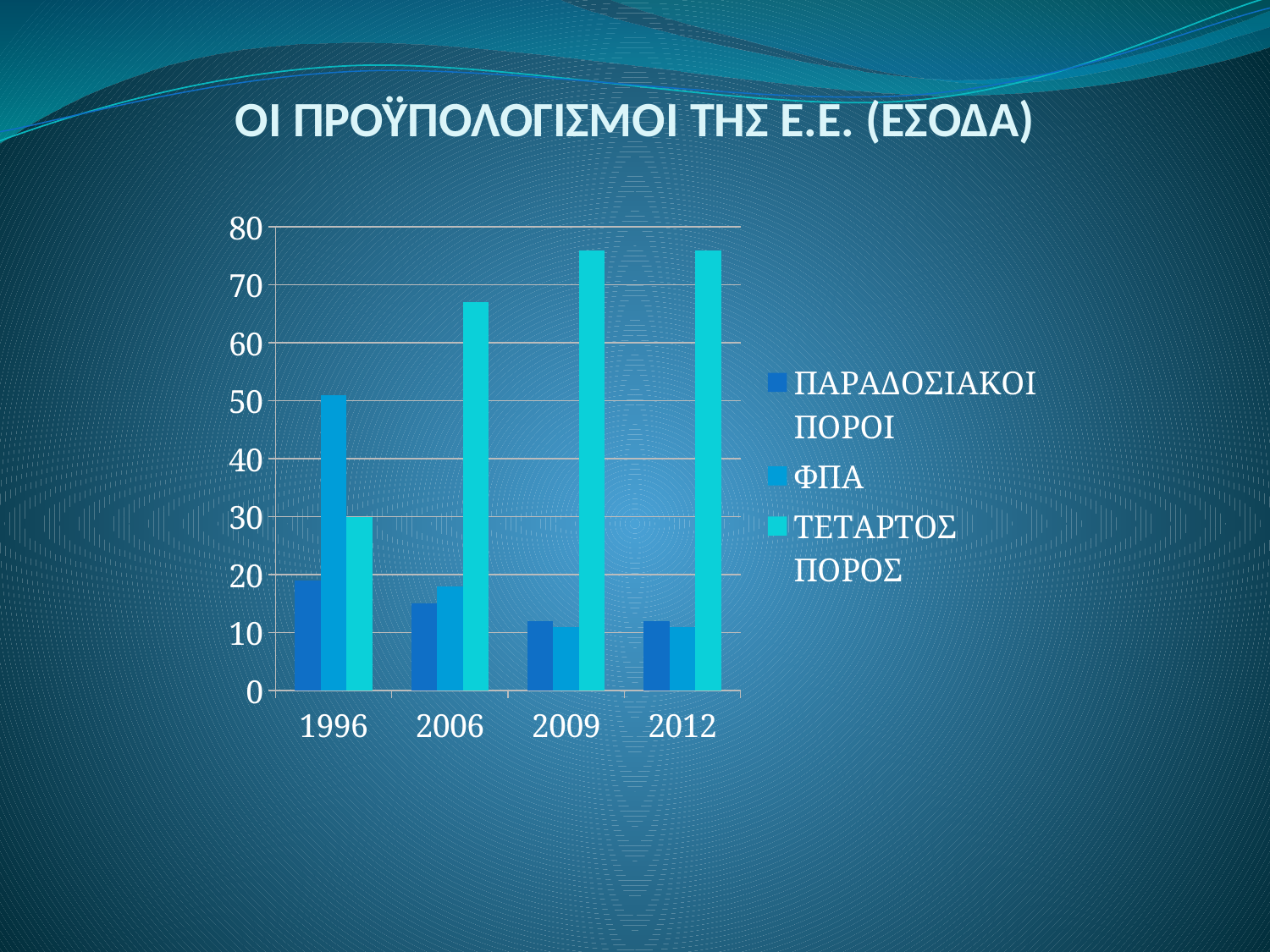
In which year is the value for ΦΠΑ highest? 1996 What is the title of the chart on the slide? ΟΙ ΠΡΟΫΠΟΛΟΓΙΣΜΟΙ ΤΗΣ Ε.Ε. (ΕΣΟΔΑ) Which series is shown in the lightest (cyan) colour in the legend? ΤΕΤΑΡΤΟΣ ΠΟΡΟΣ In which year is the value for ΤΕΤΑΡΤΟΣ ΠΟΡΟΣ lowest? 1996 In 1996, which is larger: ΦΠΑ or ΤΕΤΑΡΤΟΣ ΠΟΡΟΣ? ΦΠΑ Does the value for ΤΕΤΑΡΤΟΣ ΠΟΡΟΣ rise or fall from 1996 to 2012? rise How many years are shown on the x axis of the chart? 4 In which year is the value for ΠΑΡΑΔΟΣΙΑΚΟΙ ΠΟΡΟΙ highest? 1996 What kind of chart is shown on the slide? bar chart How many series does the chart's legend list? 3 In 2006, which is larger: ΦΠΑ or ΤΕΤΑΡΤΟΣ ΠΟΡΟΣ? ΤΕΤΑΡΤΟΣ ΠΟΡΟΣ Is the value for ΤΕΤΑΡΤΟΣ ΠΟΡΟΣ in 2009 greater or less than 70? greater